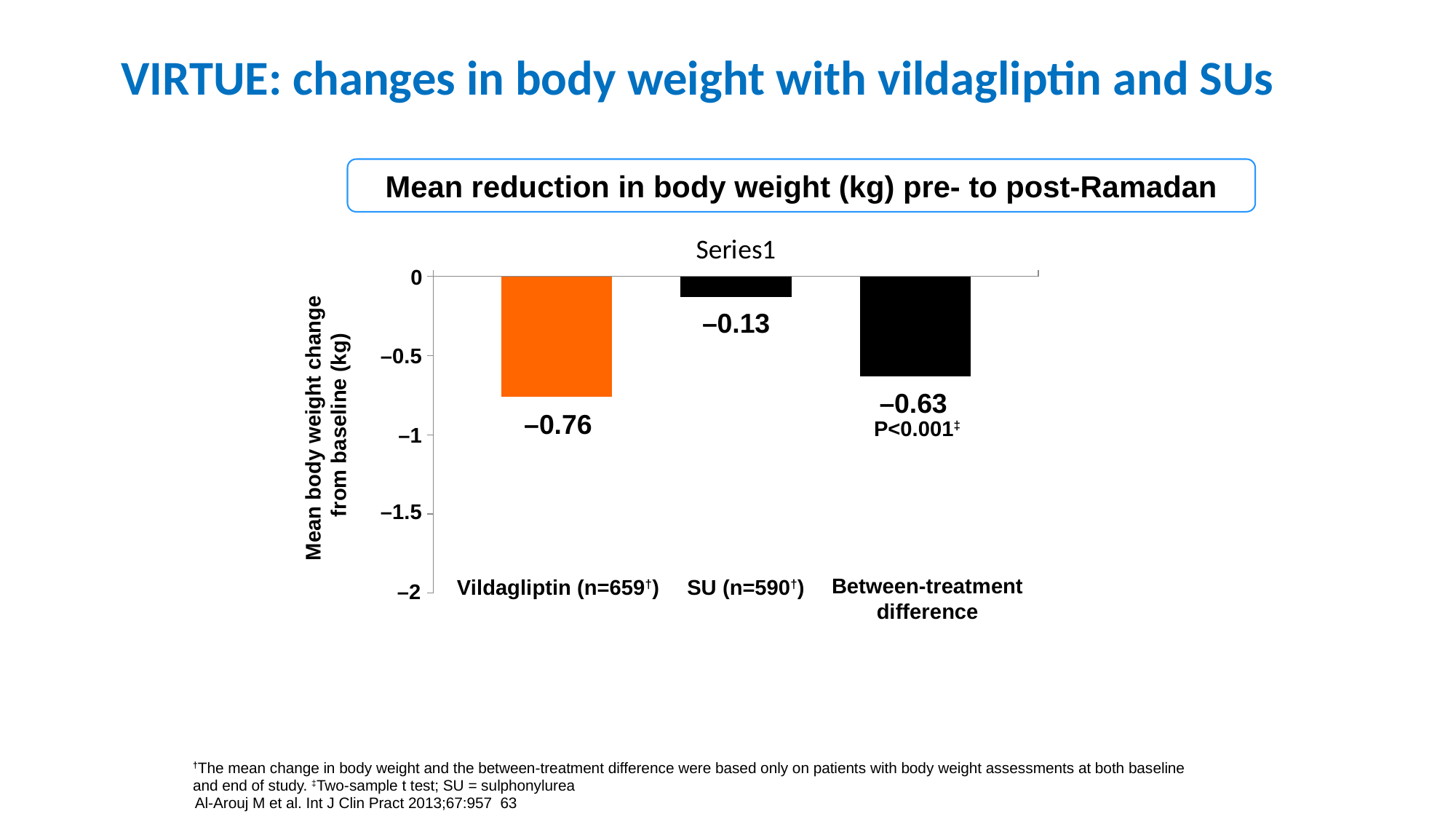
What value is shown for the between-treatment difference? –0.63 By how much does the Vildagliptin value differ from the SU value? 0.63 What is the mean body weight change from baseline for Vildagliptin (n=659)? –0.76 What is the label of the vertical axis? Mean body weight change from baseline (kg) How many bars are plotted on the chart? 3 What type of chart is shown on the slide? Bar chart Which bar is larger in magnitude, Vildagliptin or SU? Vildagliptin What is the mean body weight change from baseline for SU (n=590)? –0.13 Is the value for Vildagliptin (n=659) greater or less than –0.5? less Is the value for SU (n=590) greater or less than –0.5? greater Which category shows the largest reduction in body weight (the lowest value)? Vildagliptin (n=659) Which category has the highest (least negative) value on the chart? SU (n=590)